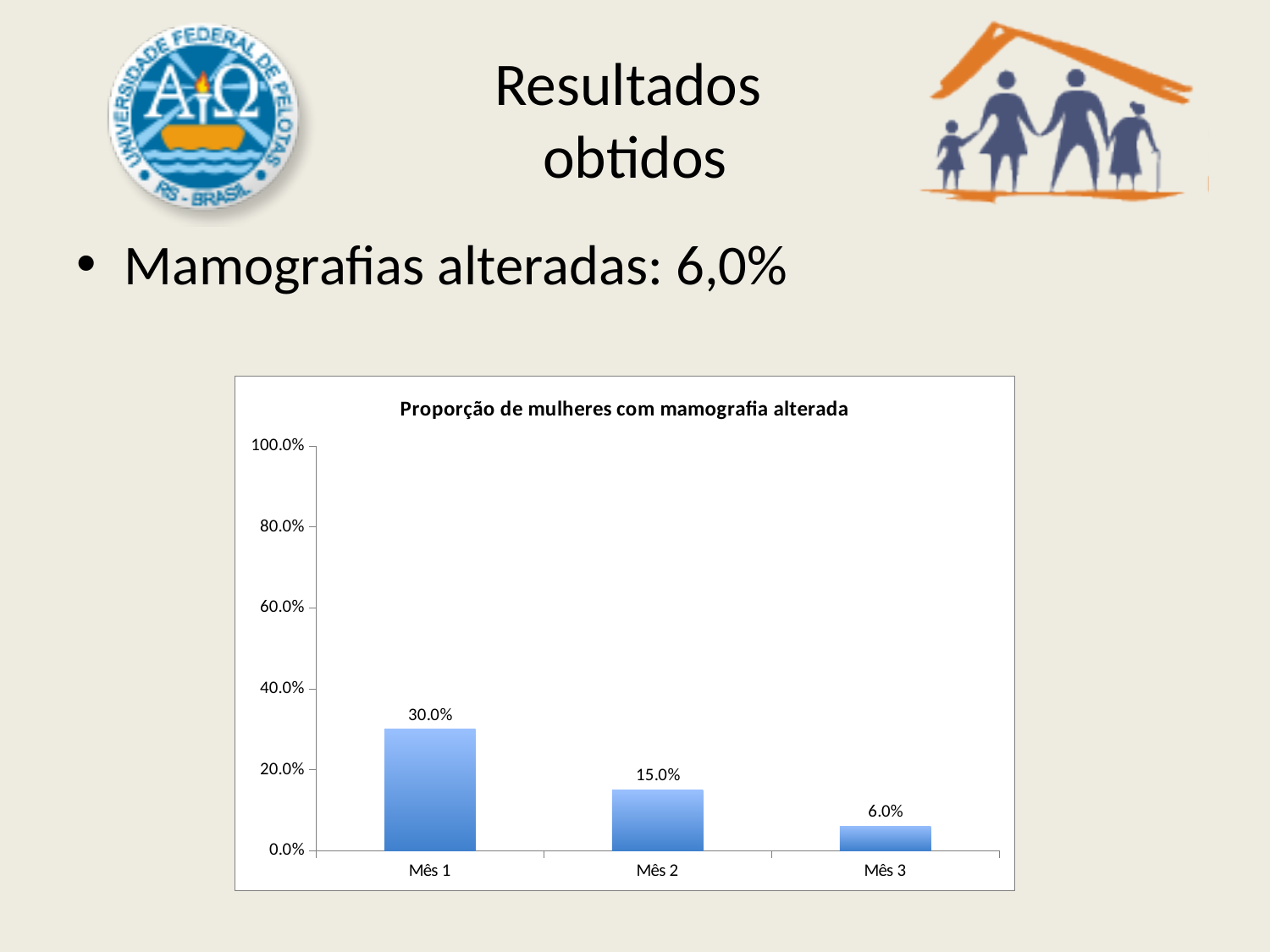
What is the difference between the values for Mês 1 and Mês 2? 15.0% Which month has the highest proportion of women with altered mammography? Mês 1 What is the value for Mês 2? 15.0% What is the value for Mês 1? 30.0% What kind of chart is shown on the slide? bar chart Which is larger, the value for Mês 2 or the value for Mês 3? Mês 2 What is the difference between the values for Mês 2 and Mês 3? 9.0% Which month has the lowest proportion of women with altered mammography? Mês 3 Is the value for Mês 1 greater or less than 20.0%? greater How many months are shown on the x axis? 3 What is the value for Mês 3? 6.0% Do the values rise or fall from Mês 1 to Mês 3? fall